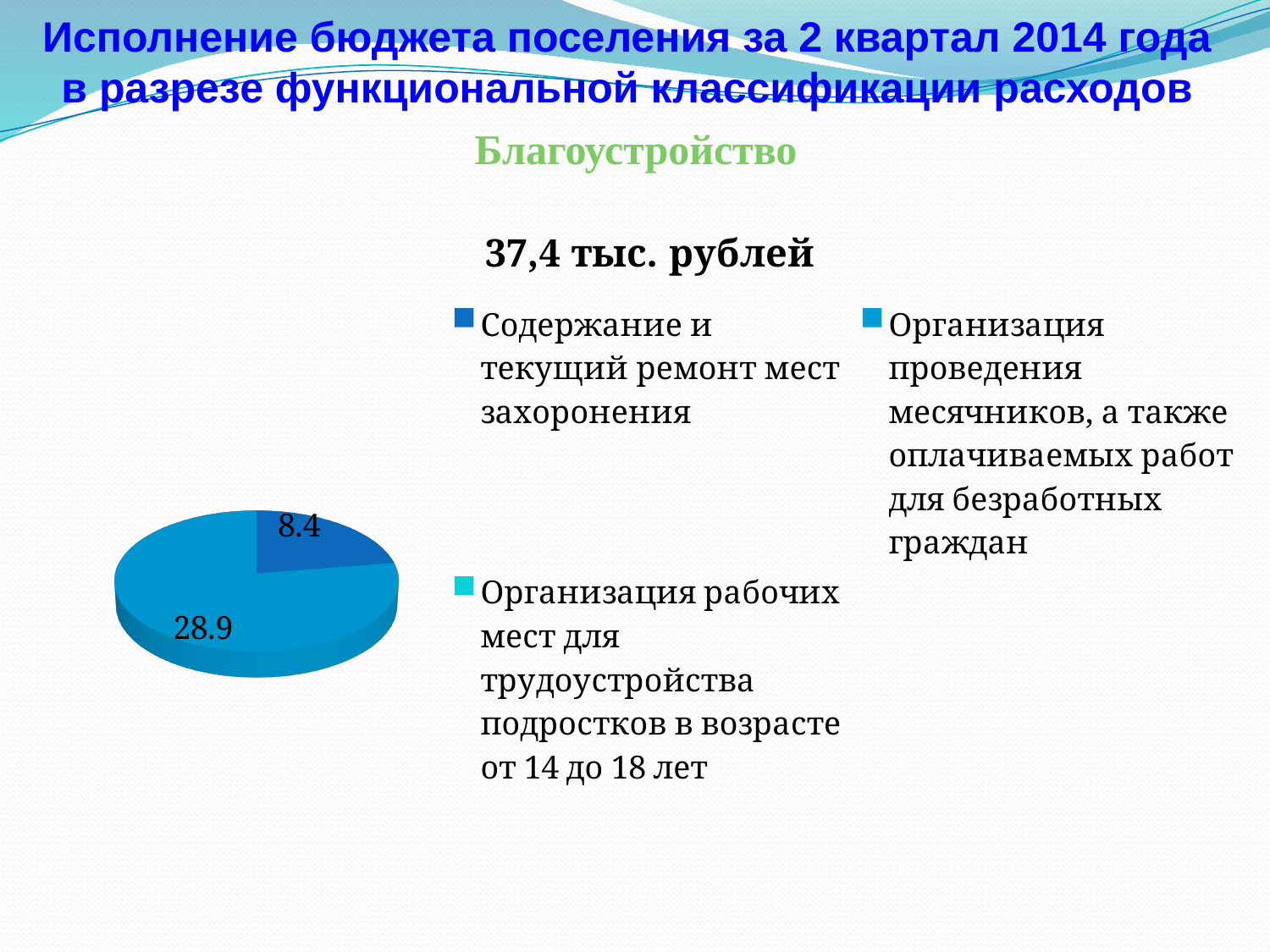
What is the difference between the two labelled slice values, 28.9 and 8.4? 20.5 Which labelled slice has the smallest value in the pie chart? Содержание и текущий ремонт мест захоронения Which legend category has the largest slice in the pie chart? Организация проведения месячников, а также оплачиваемых работ для безработных граждан What value is shown for the slice 'Содержание и текущий ремонт мест захоронения'? 8.4 What is the chart's title? 37,4 тыс. рублей What is the subtitle shown in green above the chart? Благоустройство What type of chart is shown on the slide? pie chart How many data labels are printed on the pie chart? 2 How many entries does the chart legend list? 3